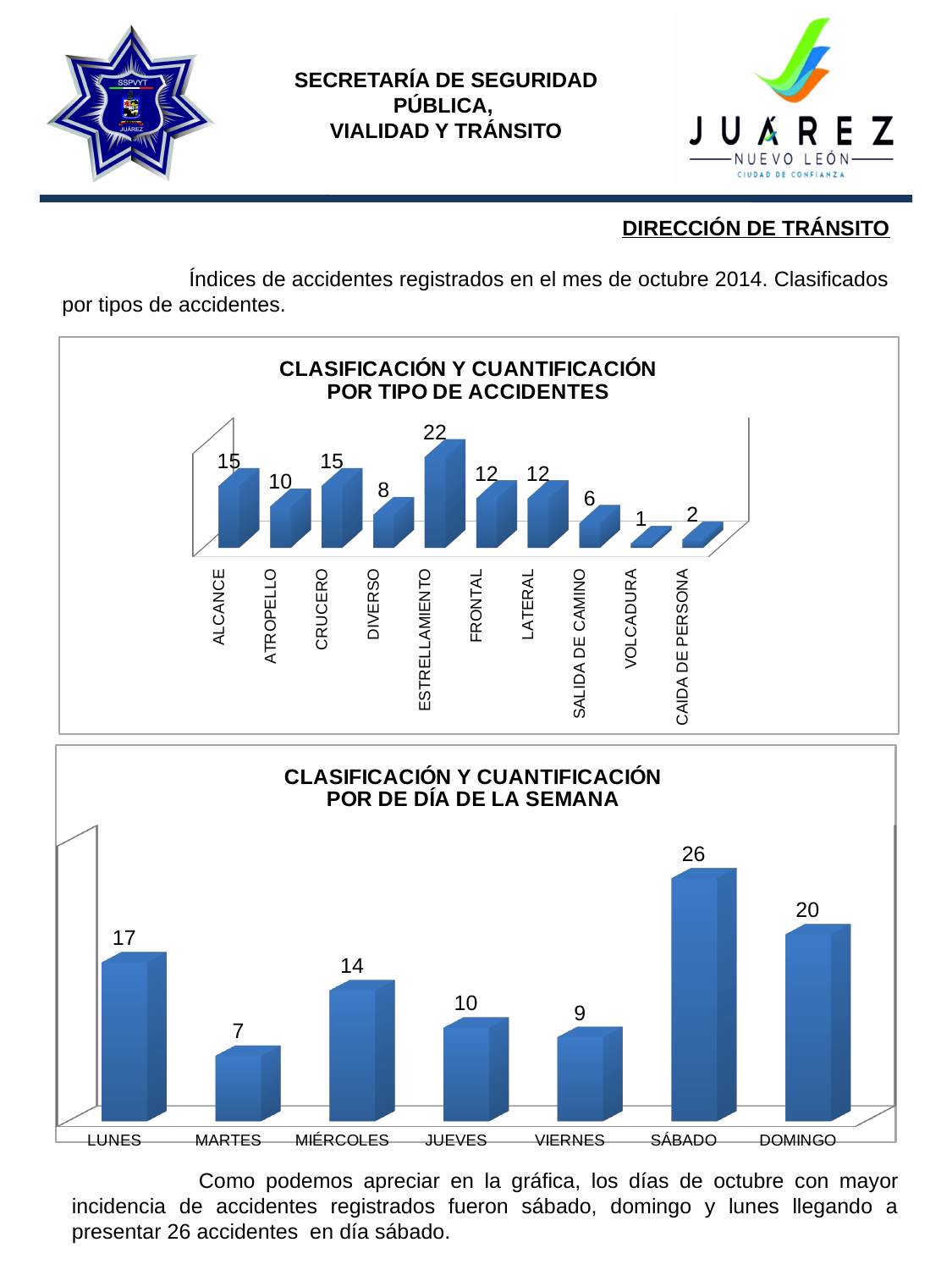
In the chart 'CLASIFICACIÓN Y CUANTIFICACIÓN POR DE DÍA DE LA SEMANA', which is larger, LUNES or DOMINGO? DOMINGO In the chart 'CLASIFICACIÓN Y CUANTIFICACIÓN POR TIPO DE ACCIDENTES', which accident type has the lowest value? VOLCADURA In the chart 'CLASIFICACIÓN Y CUANTIFICACIÓN POR DE DÍA DE LA SEMANA', what is the difference between SÁBADO and DOMINGO? 6 In the chart 'CLASIFICACIÓN Y CUANTIFICACIÓN POR TIPO DE ACCIDENTES', what is the value for ESTRELLAMIENTO? 22 In the chart 'CLASIFICACIÓN Y CUANTIFICACIÓN POR TIPO DE ACCIDENTES', which accident type has the highest value? ESTRELLAMIENTO In the chart 'CLASIFICACIÓN Y CUANTIFICACIÓN POR DE DÍA DE LA SEMANA', what is the value for SÁBADO? 26 In the chart 'CLASIFICACIÓN Y CUANTIFICACIÓN POR TIPO DE ACCIDENTES', what is the value for SALIDA DE CAMINO? 6 In the chart 'CLASIFICACIÓN Y CUANTIFICACIÓN POR TIPO DE ACCIDENTES', what is the difference between ALCANCE and ATROPELLO? 5 In the chart 'CLASIFICACIÓN Y CUANTIFICACIÓN POR DE DÍA DE LA SEMANA', how many days are shown? 7 What kind of chart is the 'CLASIFICACIÓN Y CUANTIFICACIÓN POR DE DÍA DE LA SEMANA' chart? Bar chart In the chart 'CLASIFICACIÓN Y CUANTIFICACIÓN POR TIPO DE ACCIDENTES', how many accident types are shown? 10 In the chart 'CLASIFICACIÓN Y CUANTIFICACIÓN POR DE DÍA DE LA SEMANA', which day has the lowest value? MARTES